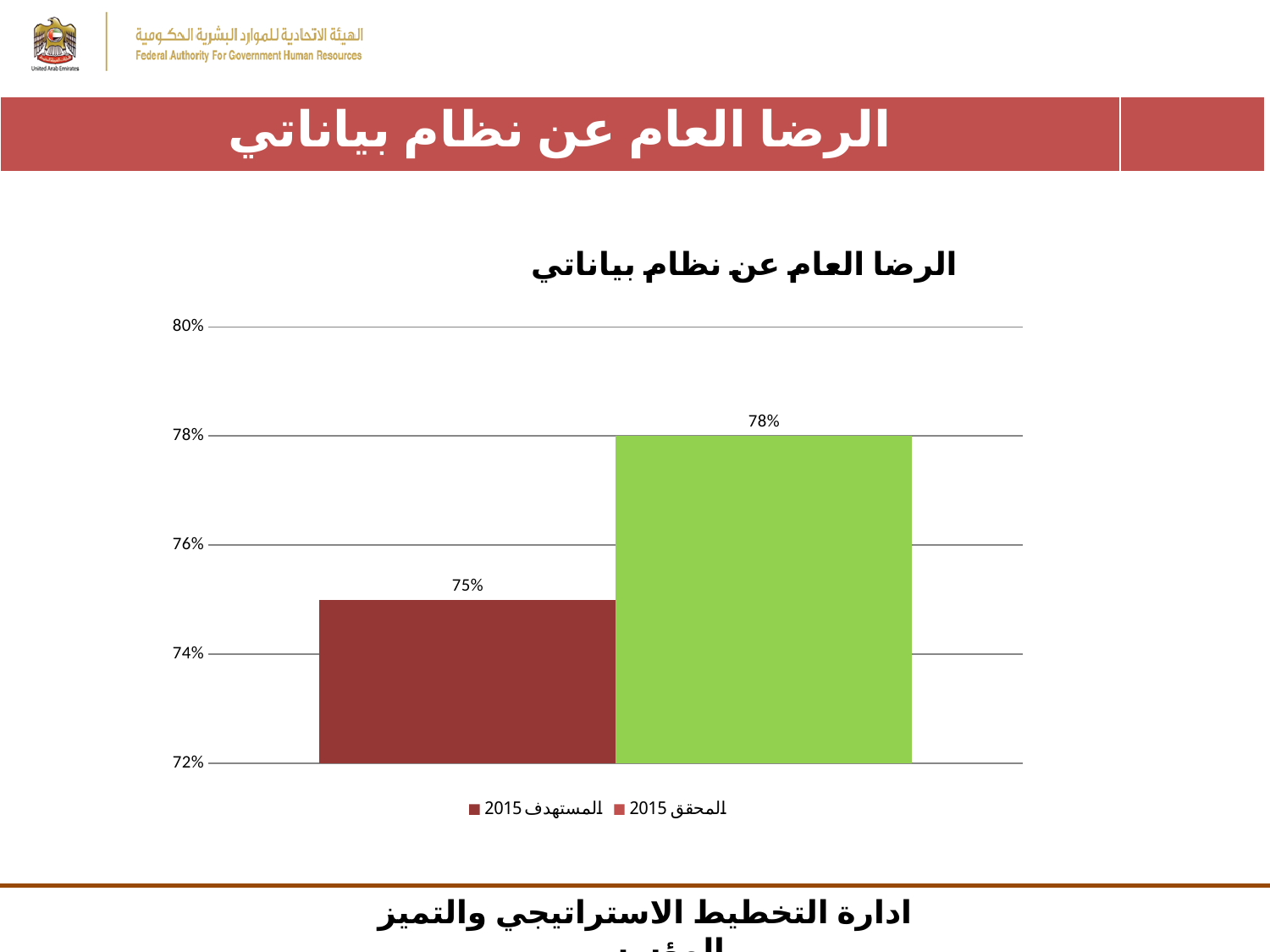
Is the value for المستهدف 2015 greater or less than 76%? less Which series has the lowest value? المستهدف 2015 What type of chart is shown on the slide? bar chart What is the value for المستهدف 2015? 75% How many series does the legend list? 2 How many bars are plotted in the chart? 2 What is the difference between the value for المحقق 2015 and the value for المستهدف 2015? 3% What colour is the bar for المحقق 2015? green Which series has the higher value, المستهدف 2015 or المحقق 2015? المحقق 2015 What is the title of the chart? الرضا العام عن نظام بياناتي What is the value for المحقق 2015? 78% Is the value for المحقق 2015 greater or less than 76%? greater